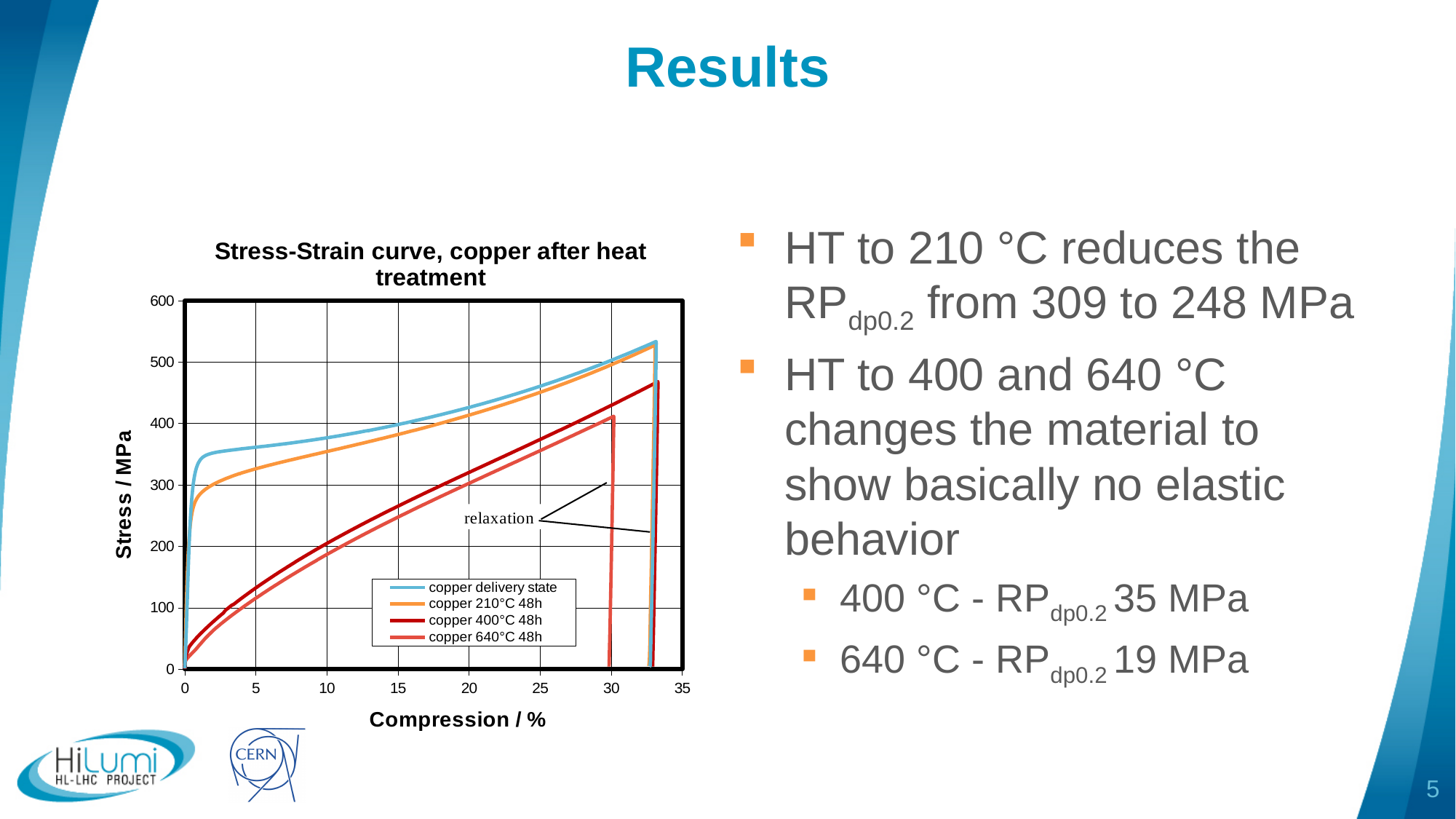
What is the title of the chart? Stress-Strain curve, copper after heat treatment Is the stress for copper 400°C 48h at 20% compression greater or less than 400 MPa? less Does the stress for copper 400°C 48h rise or fall as compression increases from 0% to 30%? rise What kind of chart is shown on the slide? line chart What is the label of the vertical axis of the chart? Stress / MPa Is the stress for copper 210°C 48h at 5% compression greater or less than 200 MPa? greater At 20% compression, which has the higher stress: copper 210°C 48h or copper 400°C 48h? copper 210°C 48h Which series shows the highest stress at 10% compression? copper delivery state How many series does the legend of the chart list? 4 Is the stress for copper delivery state at 10% compression greater or less than 300 MPa? greater Which series shows the lowest stress at 10% compression? copper 640°C 48h